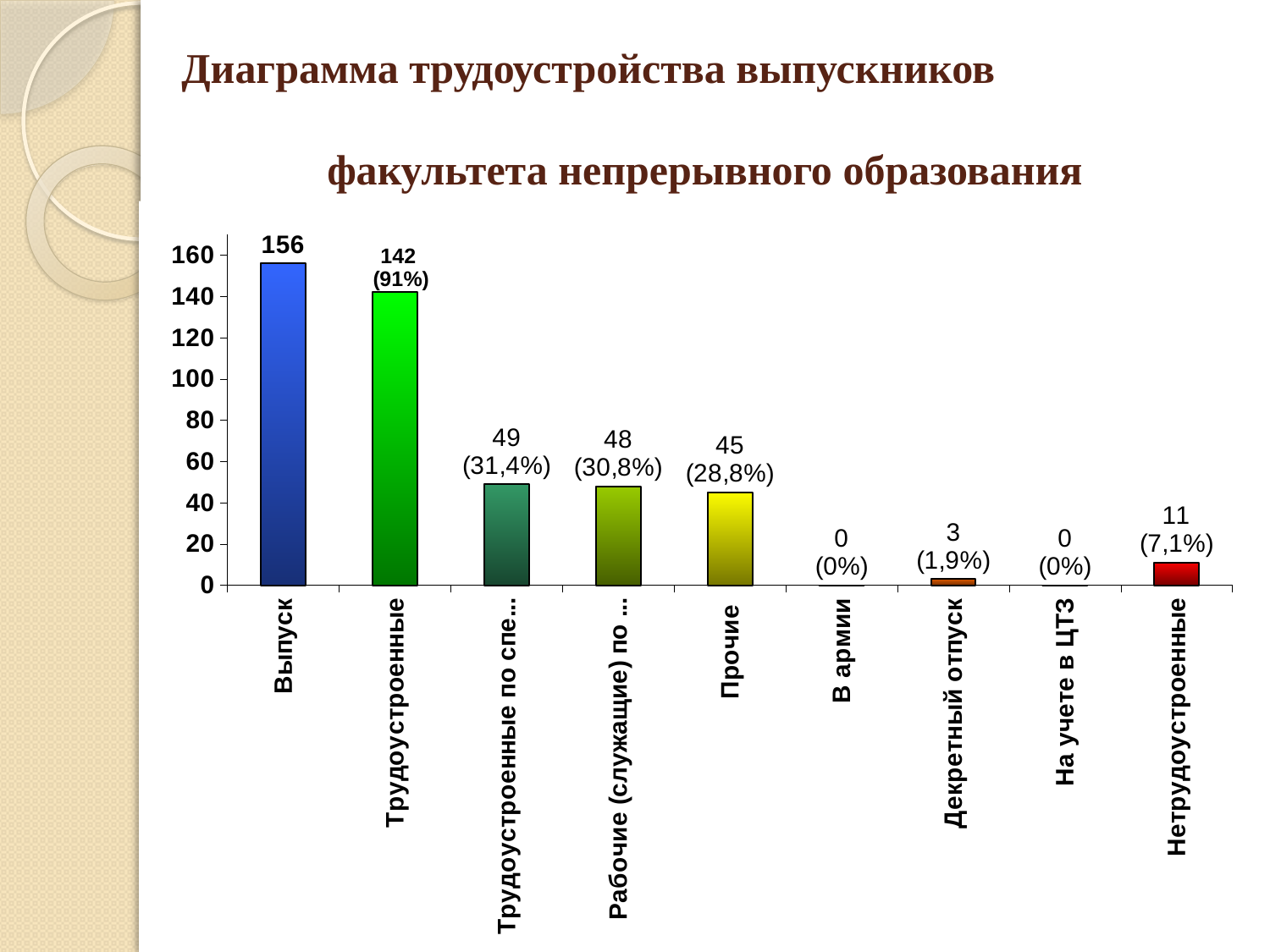
What is the difference between the values for Выпуск and Трудоустроенные? 14 How many categories are shown on the x axis? 9 What percentage is shown for Нетрудоустроенные? 7,1% What is the value for Трудоустроенные? 142 What kind of chart is shown on the slide? bar chart What is the value for Нетрудоустроенные? 11 Which category has the highest value? Выпуск What is the value for Декретный отпуск? 3 Which is larger, the value for Прочие or the value for Нетрудоустроенные? Прочие What is the value for Прочие? 45 What is the value for Выпуск? 156 What percentage is shown for Трудоустроенные? 91%